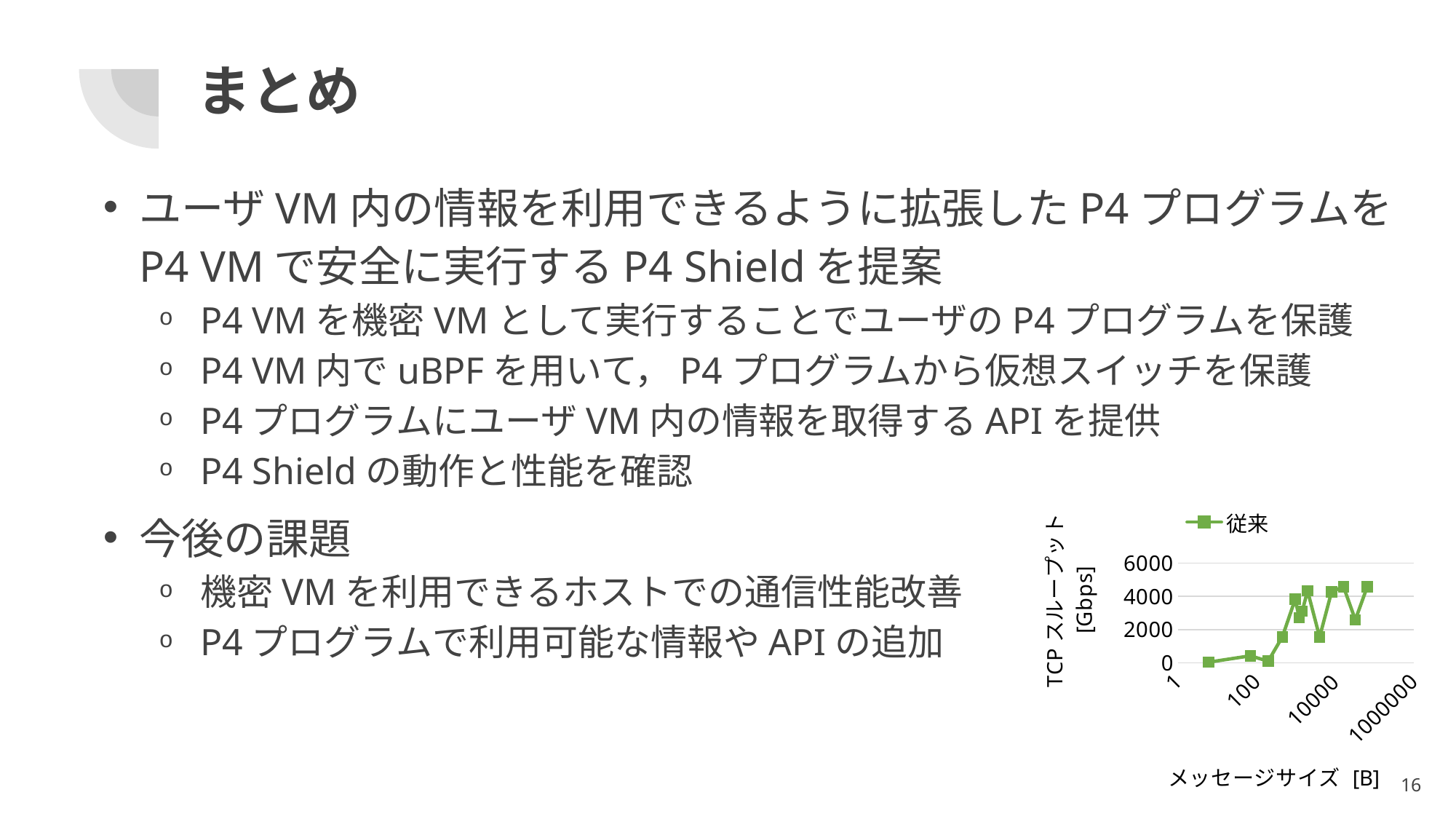
How many series does the chart's legend list? 1 What is the highest value shown on the chart's y axis? 6000 What is the label of the chart's x axis? メッセージサイズ [B] Do the TCP throughput values generally rise or fall as message size increases along the x axis? rise What kind of chart is shown on the slide? line chart What is the name of the series shown in the chart's legend? 従来